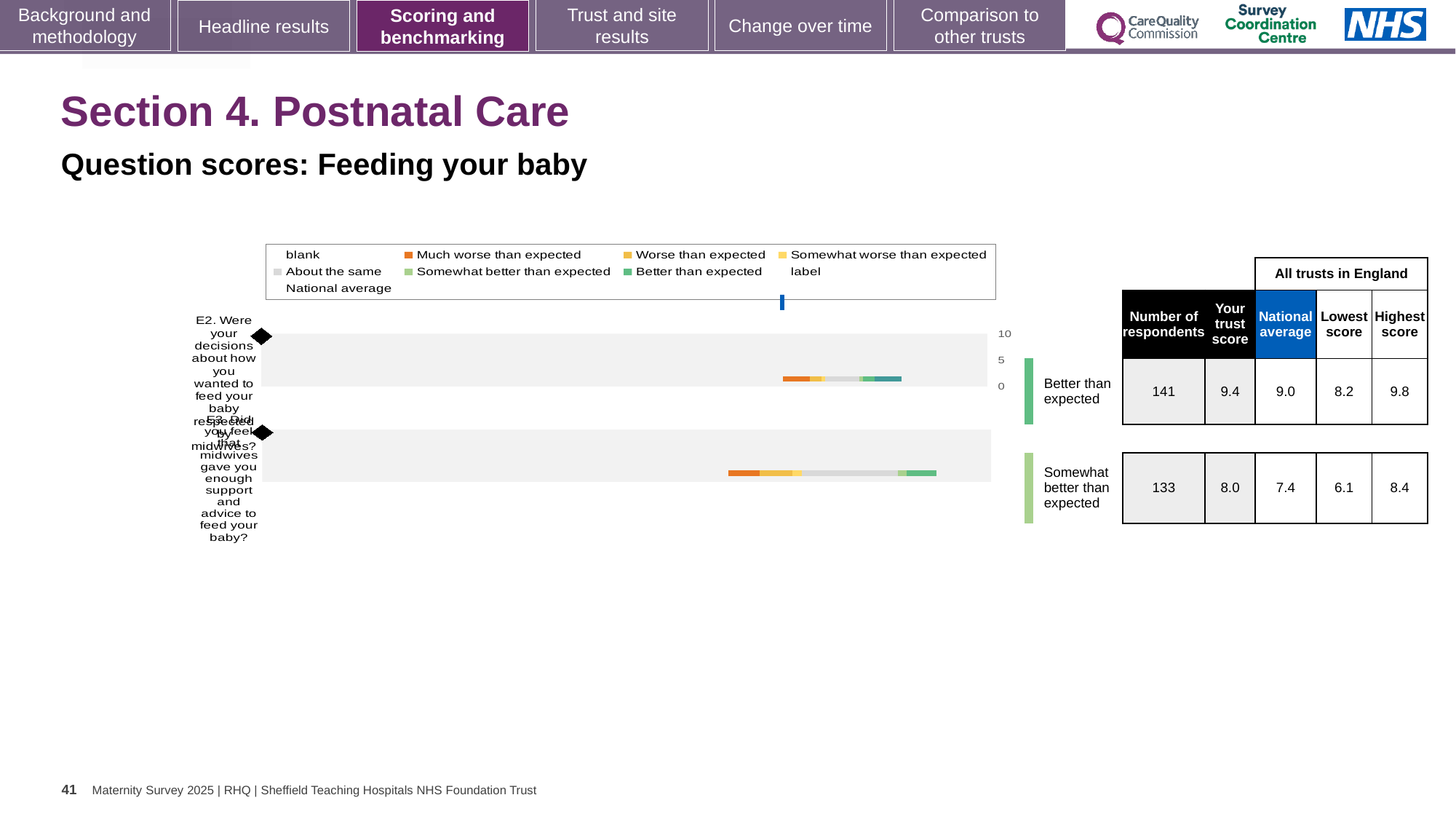
How many questions (categories) are plotted in the chart? 2 In the table beside the chart, what is the lowest score across all trusts in England for E3? 6.1 What benchmark category is E3 assigned to? Somewhat better than expected Which legend entry is shown in orange? Much worse than expected Which question has the higher trust score, E2 or E3? E2 What is the highest value shown on the chart's axis? 10 What is the difference between the trust score and the national average for E2? 0.4 What kind of chart is shown on the slide? bar chart In the table beside the chart, what is the national average for E3 (midwives gave you enough support and advice to feed your baby)? 7.4 In the table beside the chart, how many respondents answered E2? 141 In the table beside the chart, what is the trust score for E2 (decisions about how you wanted to feed your baby respected by midwives)? 9.4 What is the difference between the highest score and the lowest score for E3? 2.3